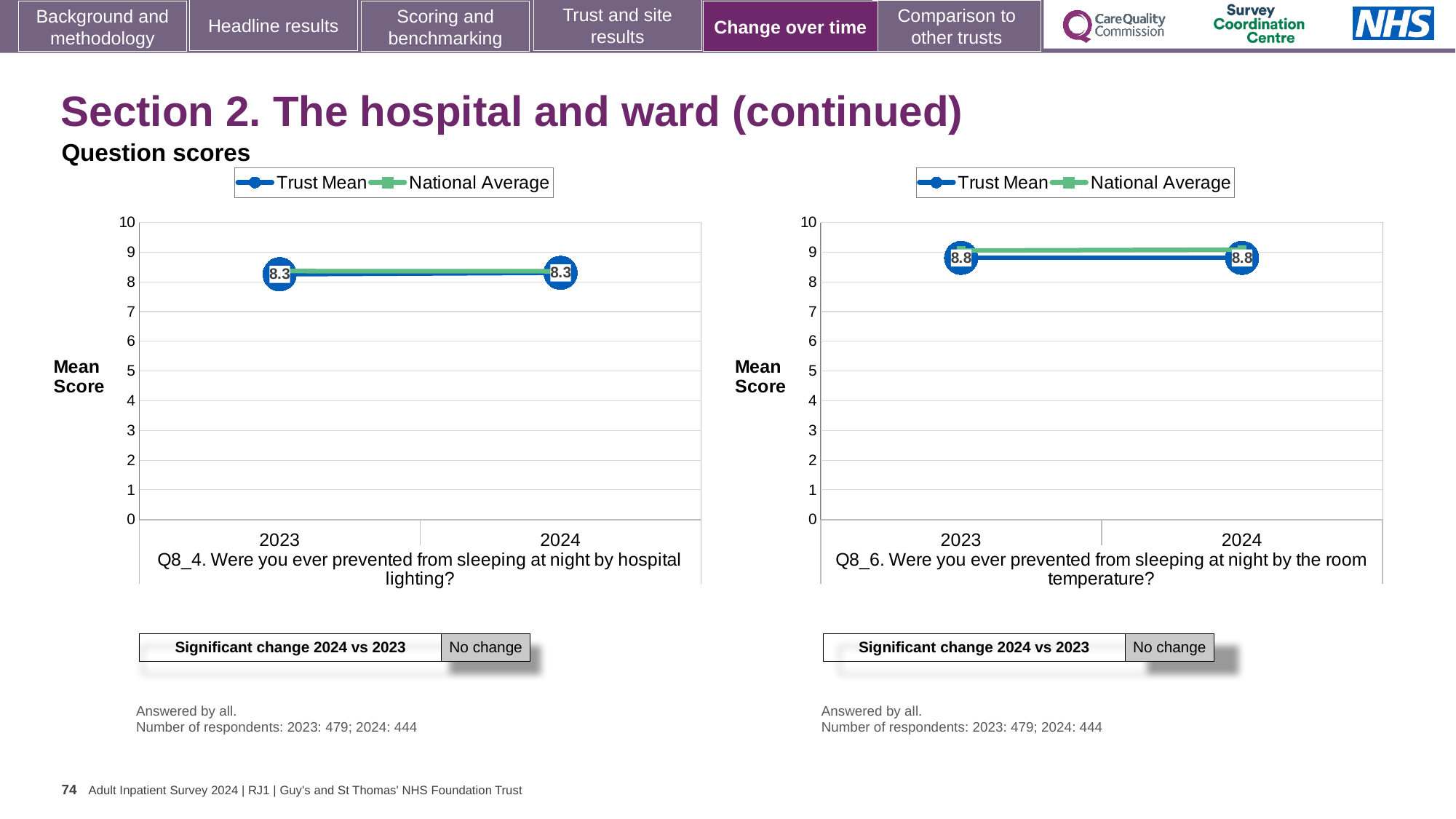
How many years are plotted on the x axis of the Q8_6 chart (right)? 2 In the Q8_6 chart (right), what is the Trust Mean score for 2024? 8.8 In the Q8_6 chart (right), which is larger in 2023, the Trust Mean or the National Average? National Average In the Q8_4 chart (left), what is the Trust Mean score for 2023? 8.3 Which chart has the higher Trust Mean in 2024, the Q8_4 chart (left) or the Q8_6 chart (right)? Q8_6 chart (right) What kind of chart is the Q8_6 chart (right)? Line chart How many series does the legend of the Q8_4 chart (left) list? 2 In the Q8_4 chart (left), what is the Trust Mean score for 2024? 8.3 In the Q8_6 chart (right), what is the difference between the Trust Mean in 2024 and in 2023? 0.0 In the Q8_6 chart (right), is the National Average for 2024 greater or less than 8? greater In the Q8_4 chart (left), does the Trust Mean rise, fall or stay the same from 2023 to 2024? Stays the same In the Q8_6 chart (right), what is the Trust Mean score for 2023? 8.8